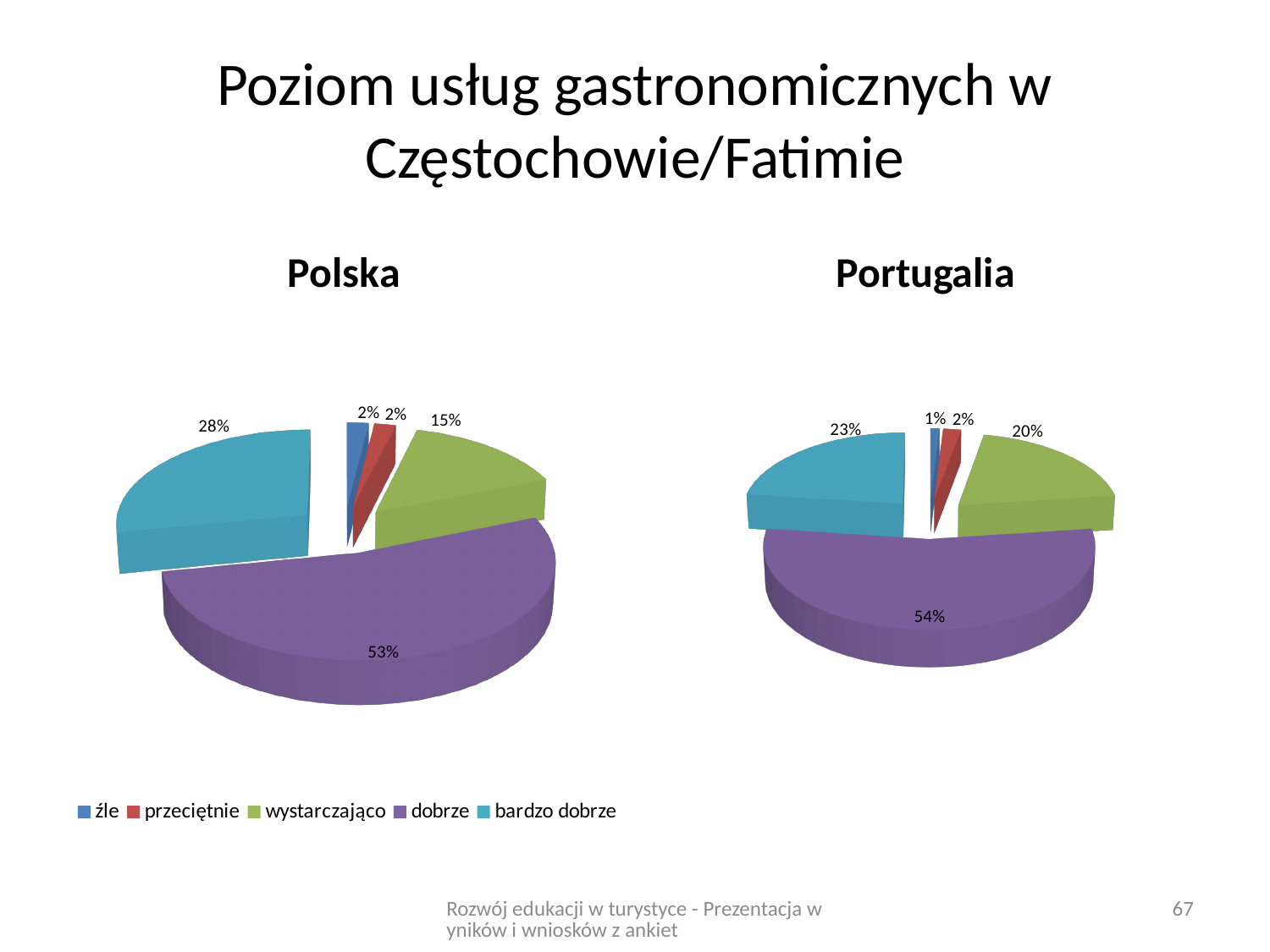
Which is larger: 'wystarczająco' in the Polska chart or 'wystarczająco' in the Portugalia chart? Portugalia In the Portugalia chart, what is the value for 'źle'? 1% What type of chart is used for Polska and Portugalia? pie chart In the Portugalia chart, what share of the pie is 'dobrze'? 54% How many slices does the Polska pie chart have? 5 In the Polska chart, what is the value for 'bardzo dobrze'? 28% In the Portugalia chart, which category has the smallest slice? źle In the Portugalia chart, what is the value for 'wystarczająco'? 20% How many entries does the legend list? 5 What is the difference between 'bardzo dobrze' in the Polska chart and 'bardzo dobrze' in the Portugalia chart? 5% In the Polska chart, which category has the largest slice? dobrze In the Polska chart, what share of the pie is 'dobrze'? 53%